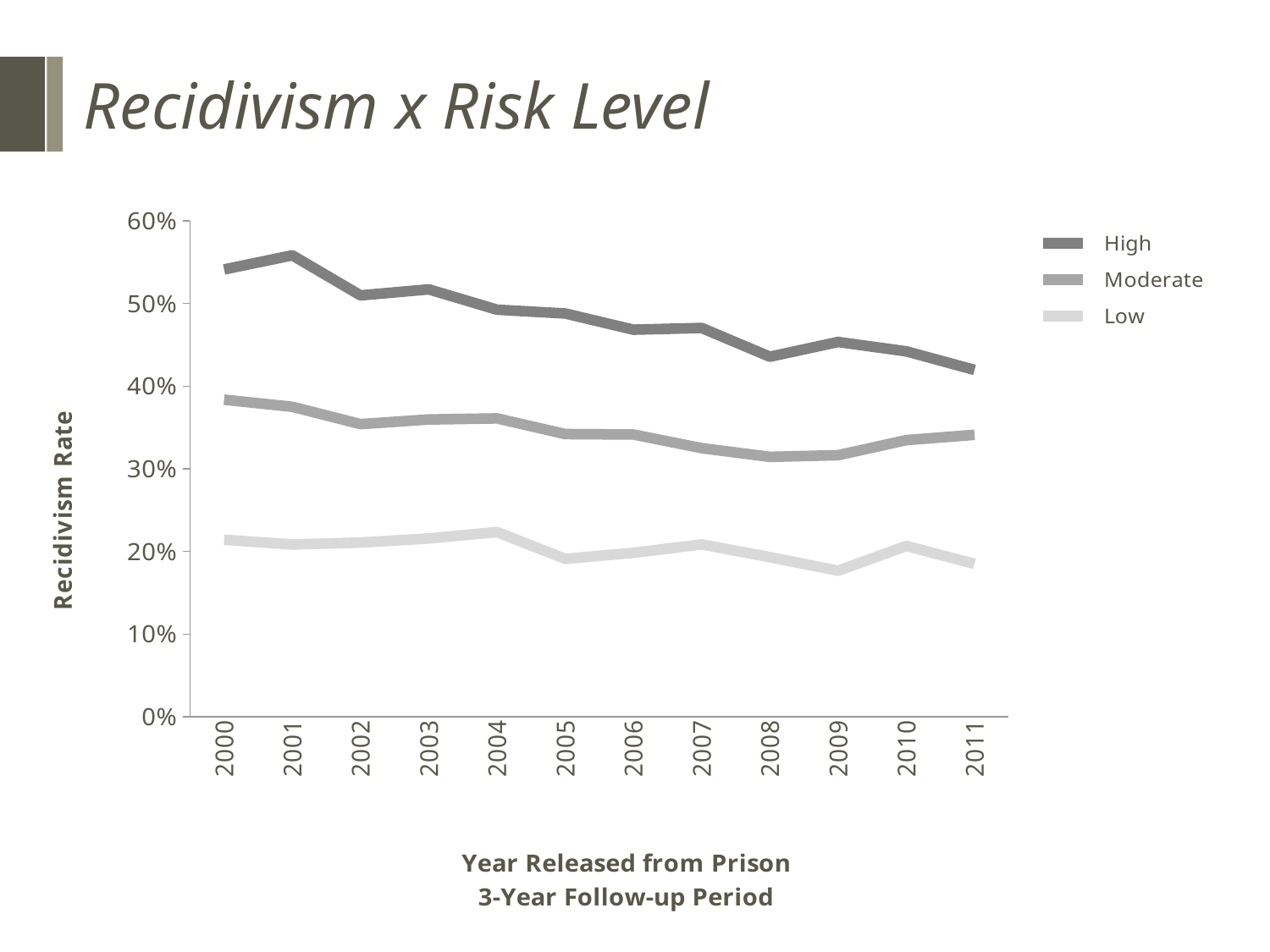
How many years are plotted along the x axis? 12 Which series is plotted highest across all years? High What kind of chart is shown on the slide? line chart What are the three entries in the legend? High, Moderate, Low Does the High series generally rise or fall from 2000 to 2011? fall How many series does the legend list? 3 Is the value for High in 2011 greater or less than 50%? less Is the value for Moderate in 2000 greater or less than 30%? greater In which year does the High series reach its highest value? 2001 Is the value for High in 2000 greater or less than 50%? greater What is the title of the y axis? Recidivism Rate